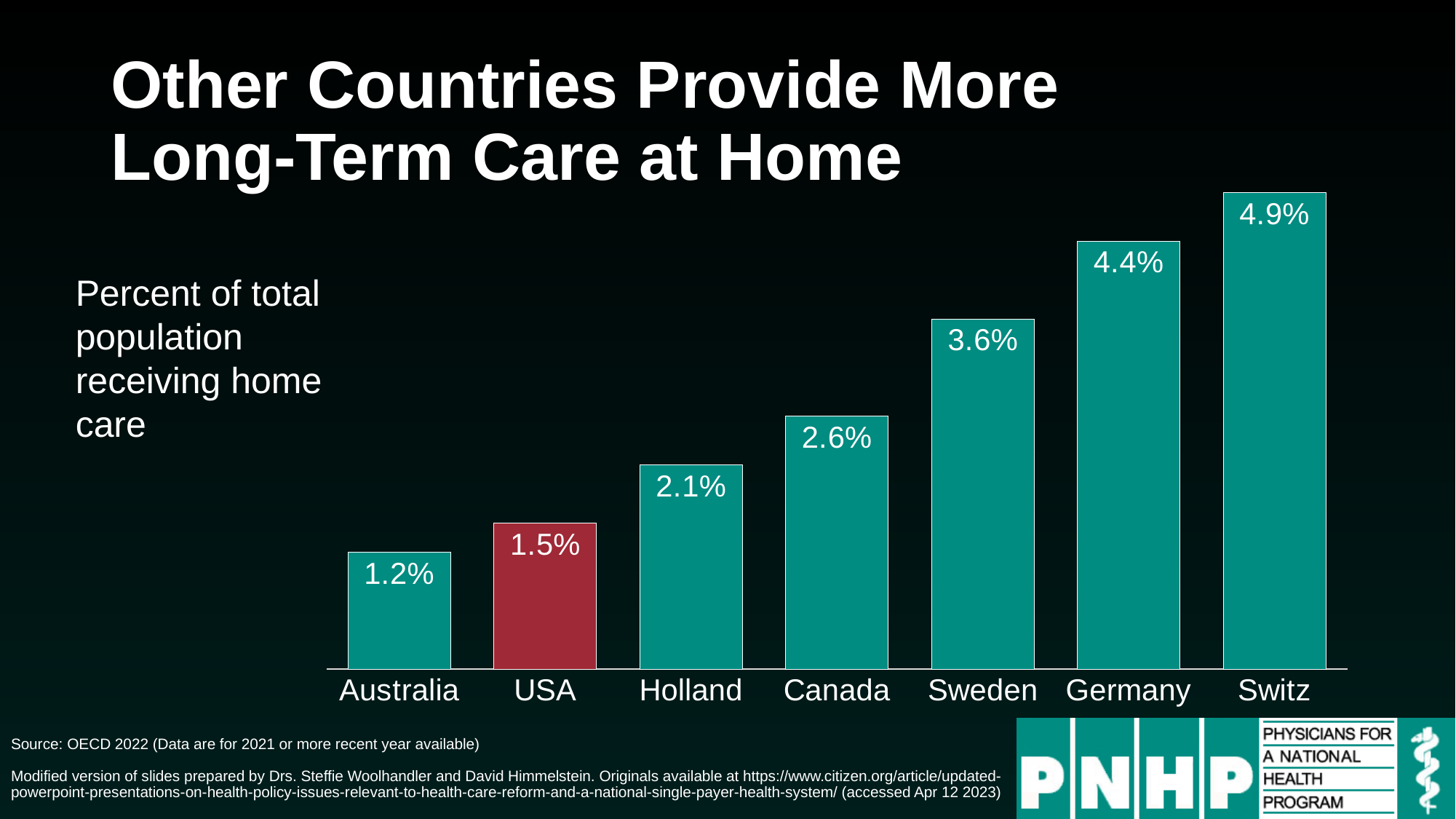
How many countries are shown in the chart? 7 Which country's bar is coloured differently (red) from the others? USA What percent of the total population receives home care in the USA? 1.5% Which country has the highest percent of population receiving home care? Switz Which has a higher value, Canada or Holland? Canada Which country has the lowest percent of population receiving home care? Australia What is the difference between the values for Switz and the USA? 3.4% What kind of chart is shown on the slide? Bar chart What is the value shown for Sweden? 3.6% What is the difference between the values for Germany and Canada? 1.8% Do the values rise or fall from left to right across the countries? Rise What is the value shown for Holland? 2.1%